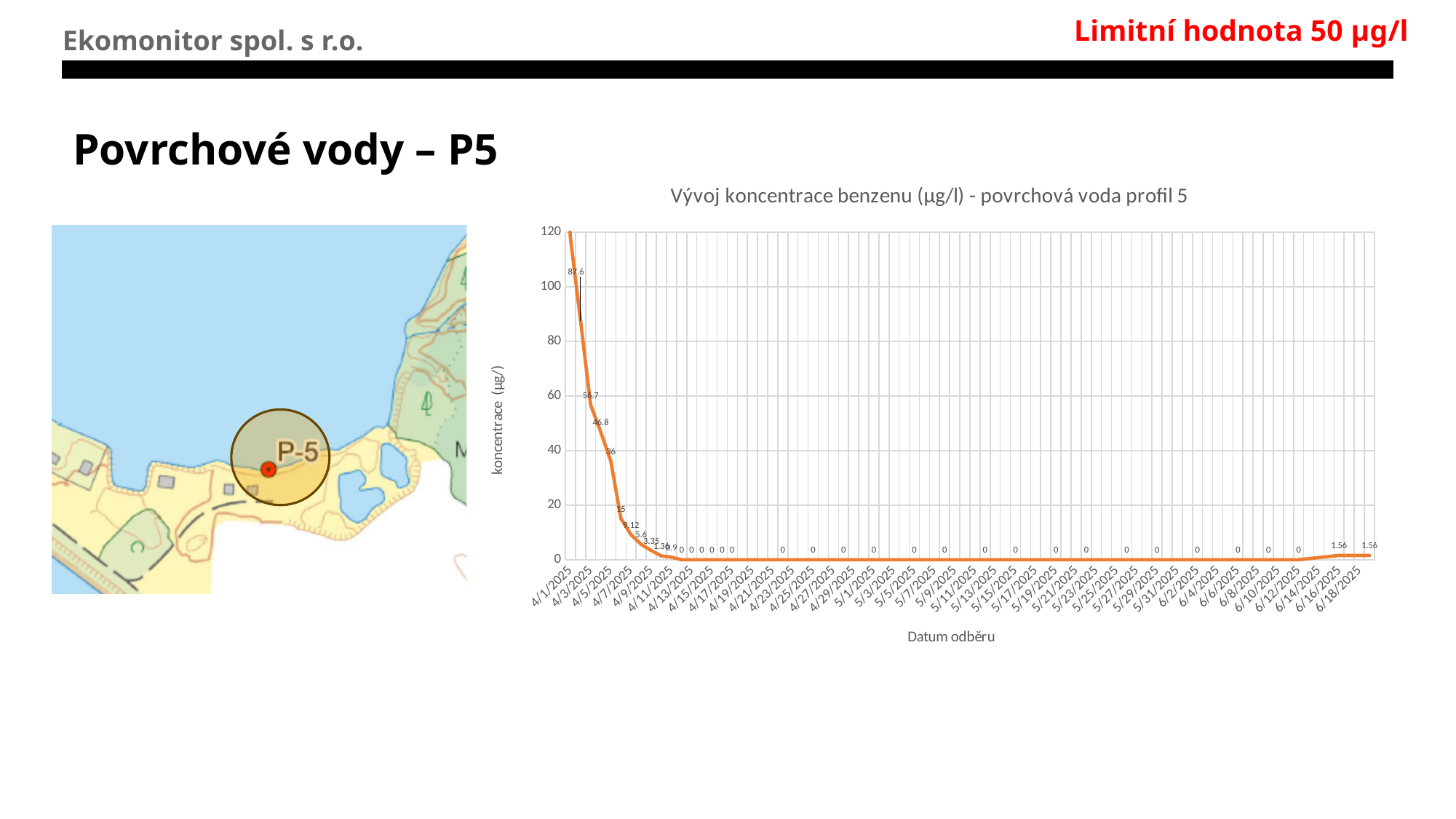
Is the value for 4/9/2025 greater or less than 20? less What is the value plotted for 5/1/2025? 0 What is the last data label shown at the right end of the line? 1.56 What is the label of the vertical axis of the chart? koncentrace (µg/l) Which date has the larger value, 4/3/2025 or 6/18/2025? 4/3/2025 What is the title of the chart? Vývoj koncentrace benzenu (µg/l) - povrchová voda profil 5 Do the values generally rise or fall from 4/1/2025 to 4/21/2025? fall Is the value for 4/1/2025 greater or less than 100? greater What is the highest tick value shown on the vertical axis? 120 Is the value for 4/5/2025 greater or less than 60? less What is the value plotted for 5/15/2025? 0 What kind of chart is shown on the slide? line chart